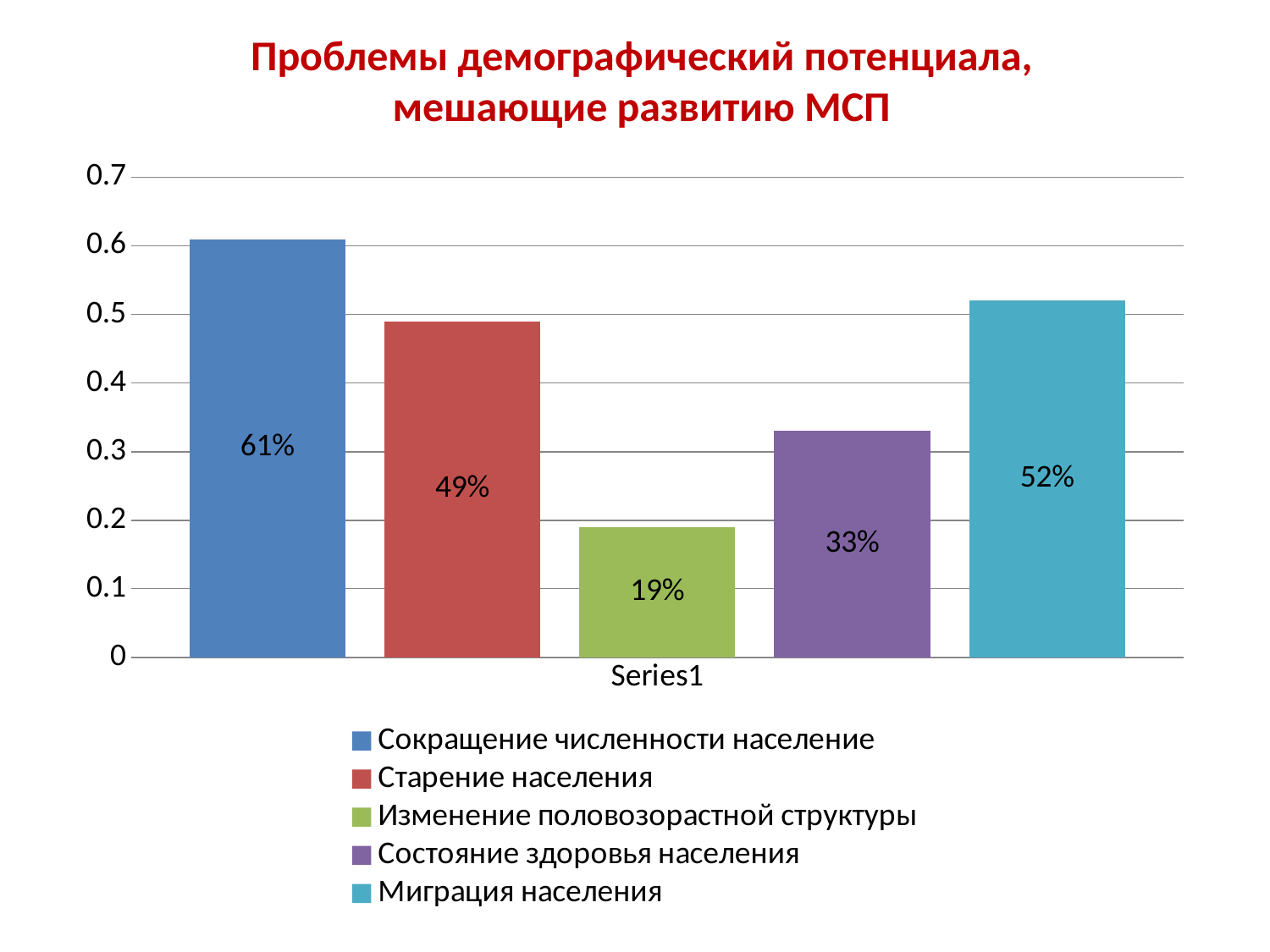
What kind of chart is shown on the slide? Bar chart What is the value for Сокращение численности население? 61% What is the value for Миграция населения? 52% What is the difference between the values for Сокращение численности население and Миграция населения? 9% What is the title of the chart? Проблемы демографический потенциала, мешающие развитию МСП What is the value for Старение населения? 49% Which is larger, the value for Старение населения or the value for Состояние здоровья населения? Старение населения What is the value for Состояние здоровья населения? 33% What is the value for Изменение половозорастной структуры? 19% How many bars are shown in the chart? 5 Which category has the highest value? Сокращение численности население Which category has the lowest value? Изменение половозорастной структуры